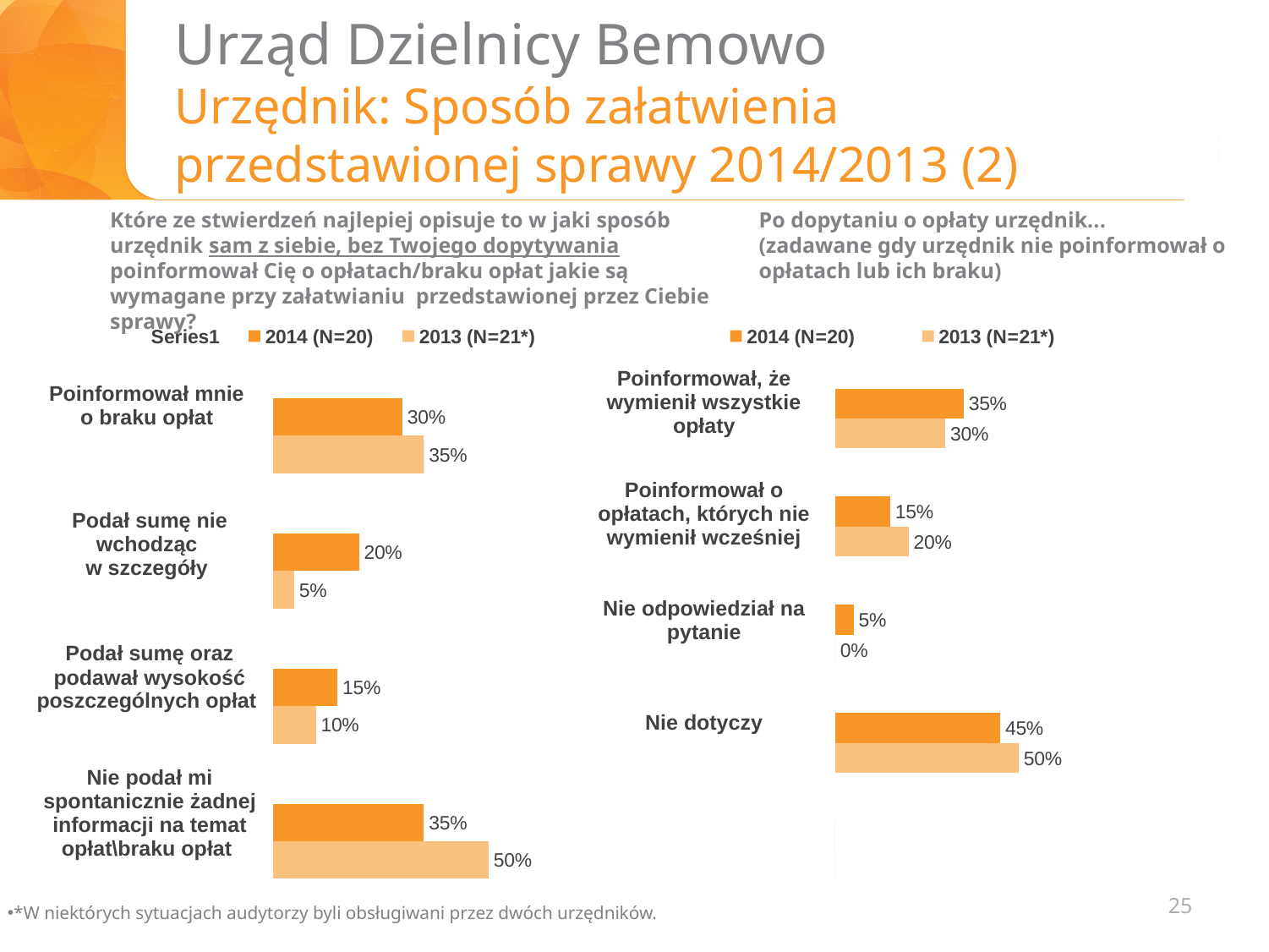
What type of chart is the right chart? Bar chart In the right chart, what is the difference between the 2014 (N=20) and 2013 (N=21*) values for 'Poinformował, że wymienił wszystkie opłaty'? 5% In the right chart, what is the 2014 (N=20) value for 'Nie dotyczy'? 45% In the left chart, what is the 2014 (N=20) value for 'Poinformował mnie o braku opłat'? 30% In the left chart, for 'Podał sumę nie wchodząc w szczegóły', which is larger: the 2014 (N=20) value or the 2013 (N=21*) value? 2014 (N=20) In the right chart, which category has the highest 2013 (N=21*) value? Nie dotyczy In the left chart, which category has the lowest 2013 (N=21*) value? Podał sumę nie wchodząc w szczegóły In the left chart, what is the difference between the 2013 (N=21*) and 2014 (N=20) values for 'Nie podał mi spontanicznie żadnej informacji na temat opłat\braku opłat'? 15% In the left chart, what is the 2013 (N=21*) value for 'Nie podał mi spontanicznie żadnej informacji na temat opłat\braku opłat'? 50% How many series does the legend of the right chart list? 2 How many categories are shown in the left chart? 4 In the right chart, what is the 2013 (N=21*) value for 'Nie odpowiedział na pytanie'? 0%